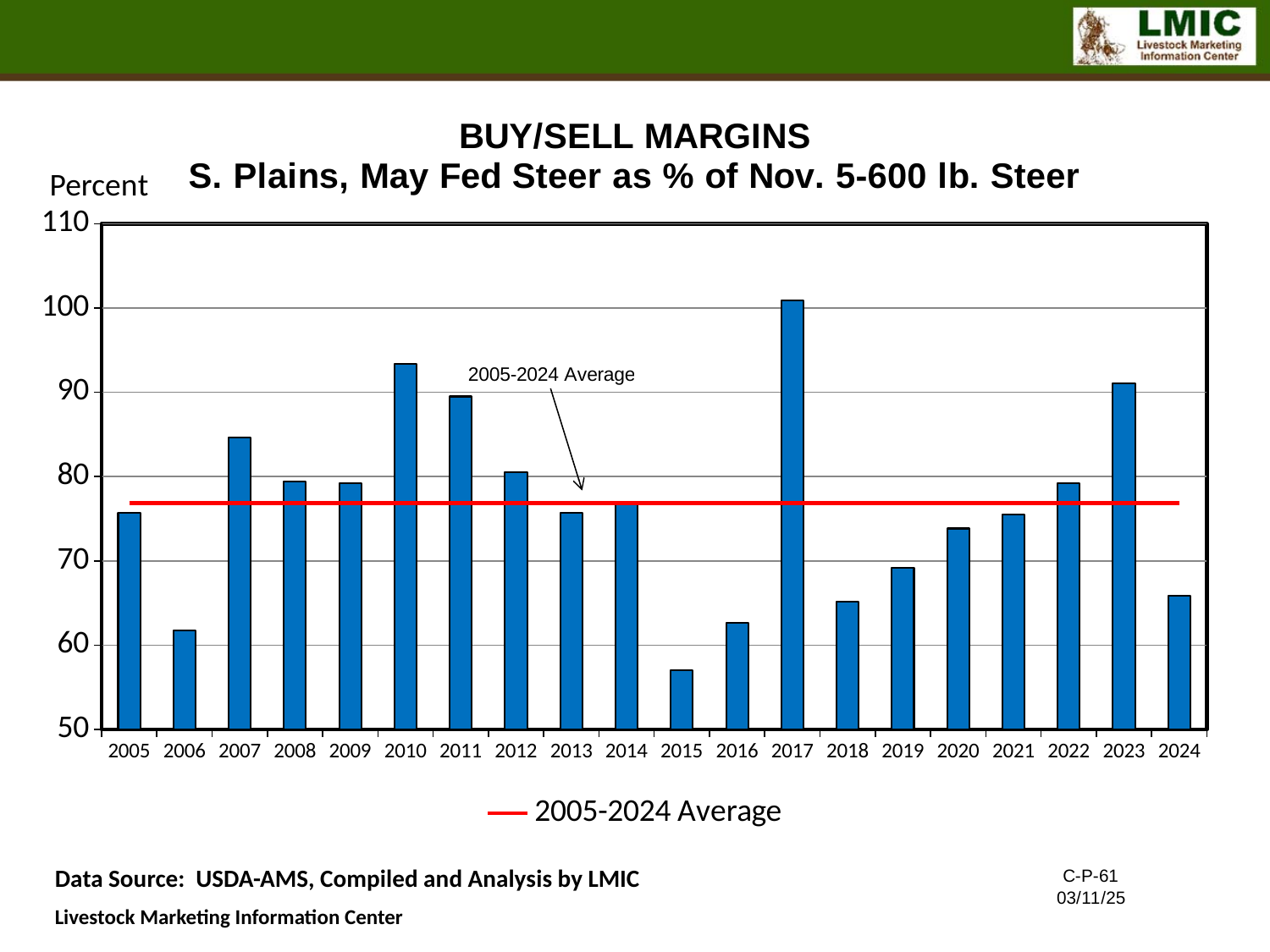
Is the value for 2019 greater or less than 70? less Is the value for 2017 greater or less than 100? greater Is the value for 2015 greater or less than 60? less Which year has the lowest buy/sell margin? 2015 How many years are shown on the x axis? 20 Which year has the highest buy/sell margin? 2017 Which year has the larger value, 2010 or 2011? 2010 What kind of chart is shown on the slide? Bar chart Which year has the larger value, 2015 or 2016? 2016 What does the red horizontal line represent? 2005-2024 Average